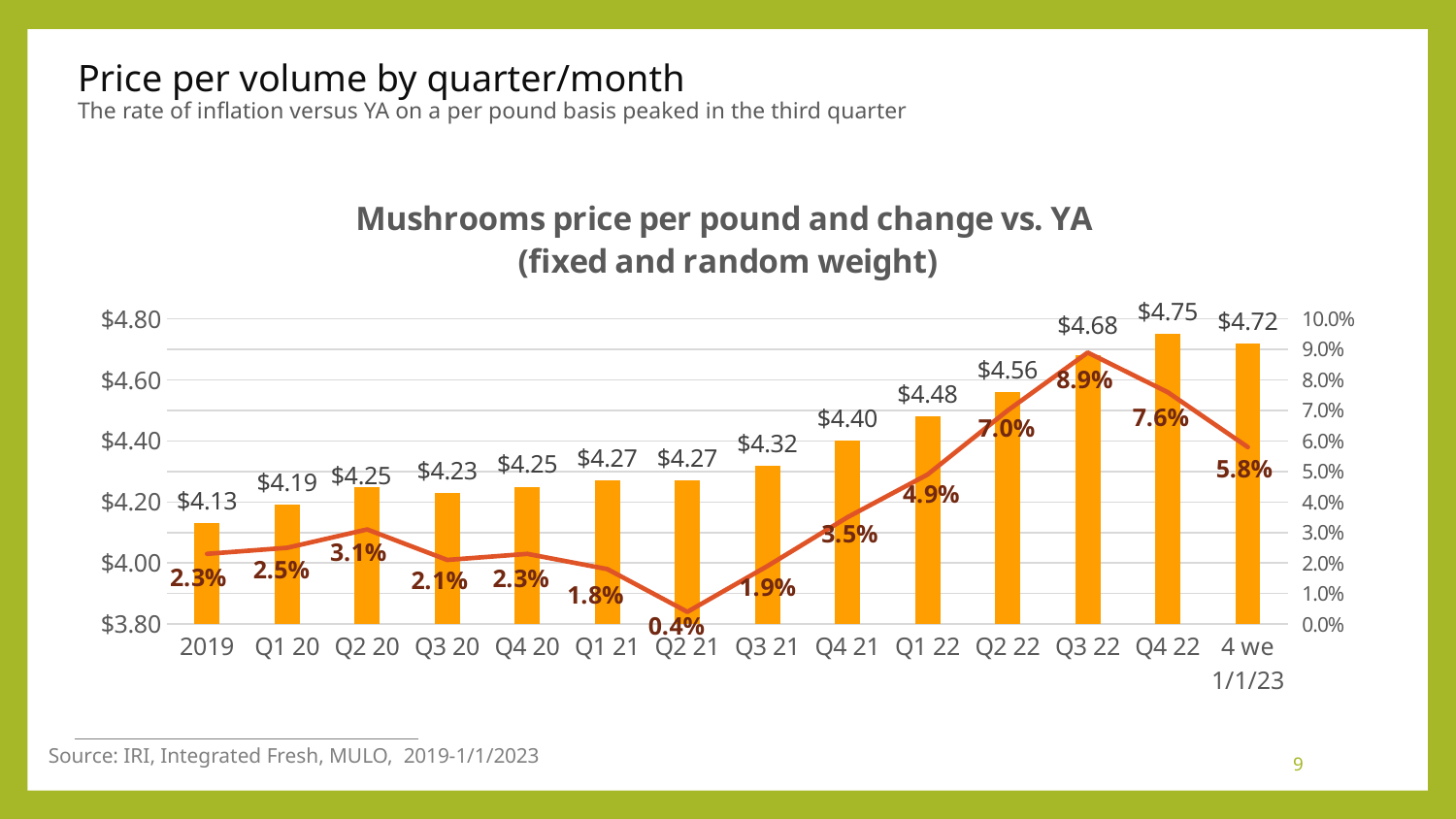
Which period has the lowest change vs. YA? Q2 21 Which period has the highest price per pound? Q4 22 Which has a higher change vs. YA, Q1 22 or Q4 22? Q4 22 Do the price per pound bars generally rise or fall from 2019 to Q4 22? Rise What is the change vs. YA shown for Q2 21? 0.4% What is the difference in price per pound between Q4 22 and 2019? $0.62 How many periods are shown on the x axis? 14 What is the price per pound for Q3 22? $4.68 Which period has the highest change vs. YA? Q3 22 What kind of chart is this? Combination bar and line chart What is the title of the chart? Mushrooms price per pound and change vs. YA (fixed and random weight) What is the price per pound for the 4 we 1/1/23 period? $4.72